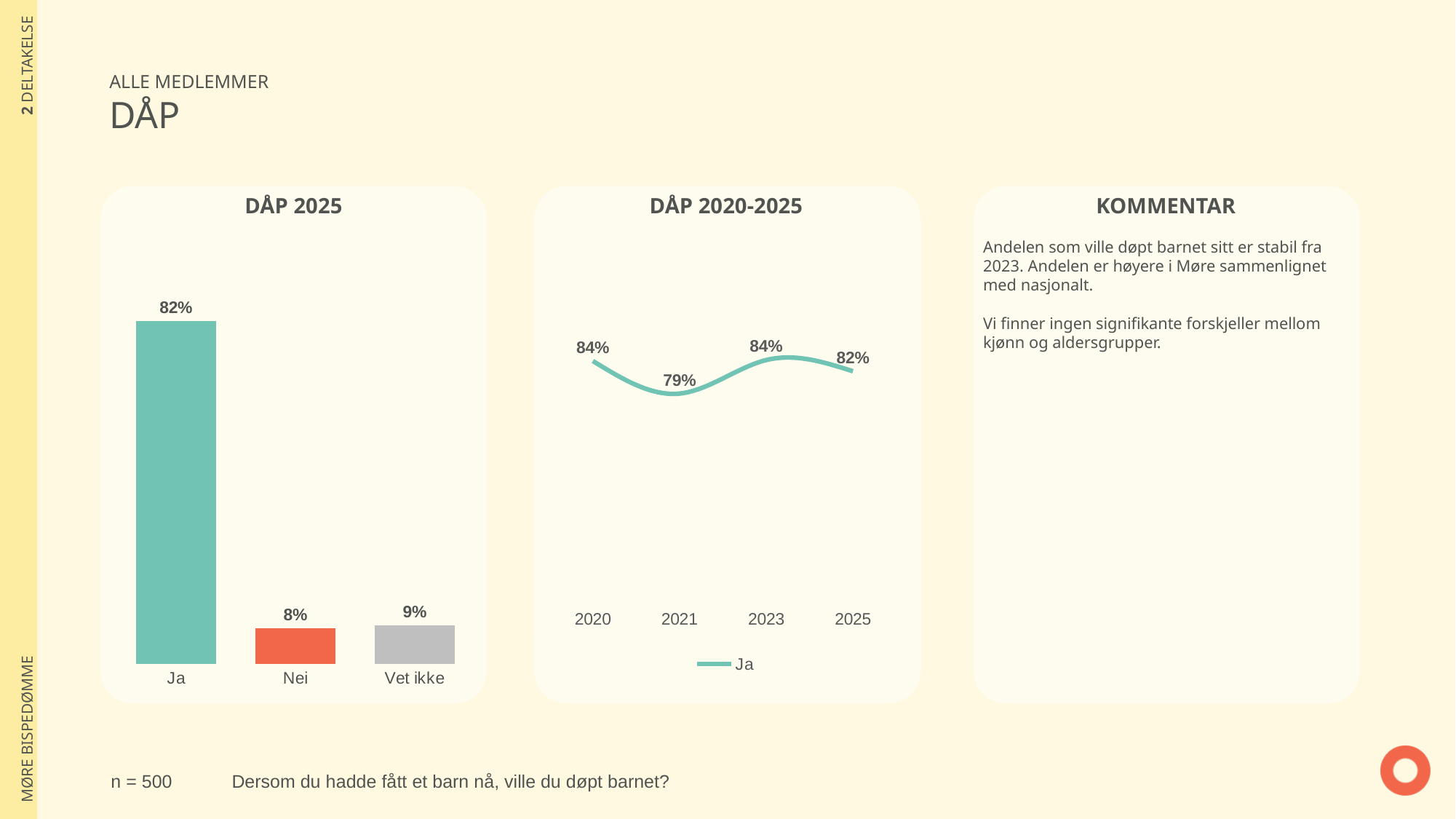
In the DÅP 2020-2025 chart, which year has the lowest value? 2021 In the DÅP 2020-2025 chart, what is the value for 2021? 79% In the DÅP 2025 chart, which category has the highest value? Ja In the DÅP 2025 chart, what is the difference between Ja and Vet ikke? 73% In the DÅP 2025 chart, how many categories are shown? 3 What kind of chart is the DÅP 2020-2025 chart? Line chart In the DÅP 2020-2025 chart, how many series does the legend list? 1 In the DÅP 2025 chart, which category has the lowest value? Nei In the DÅP 2025 chart, what is the value for Nei? 8% In the DÅP 2025 chart, what is the value for Ja? 82% What kind of chart is the DÅP 2025 chart? Bar chart In the DÅP 2020-2025 chart, what is the difference between 2023 and 2025? 2%